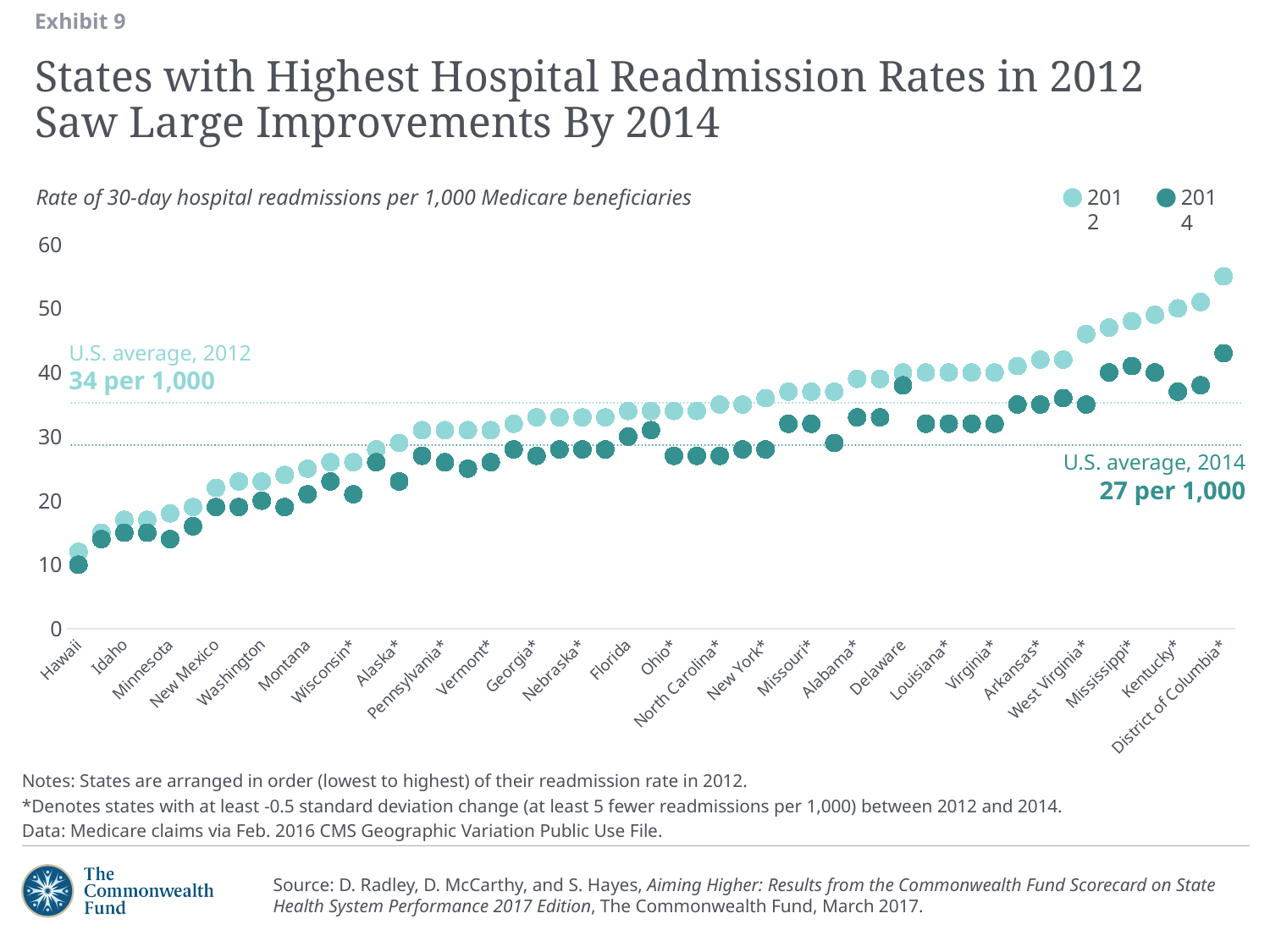
By how much did the U.S. average readmission rate fall between 2012 and 2014, according to the chart annotations? 7 per 1,000 Is the 2012 value for Florida greater or less than 30? greater What is the U.S. average readmission rate for 2012 shown on the chart? 34 per 1,000 What is the U.S. average readmission rate for 2014 shown on the chart? 27 per 1,000 Do the 2012 values rise or fall moving from left to right along the x axis? rise Is the 2014 value for Idaho greater or less than 20? less Which state has the highest 2012 readmission rate on the chart? District of Columbia Is the 2012 value for District of Columbia greater or less than 50? greater For Kentucky, which year has the higher readmission rate, 2012 or 2014? 2012 What kind of chart is shown on the slide? dot (scatter) chart How many series does the legend list? 2 Which state has the lowest 2012 readmission rate on the chart? Hawaii